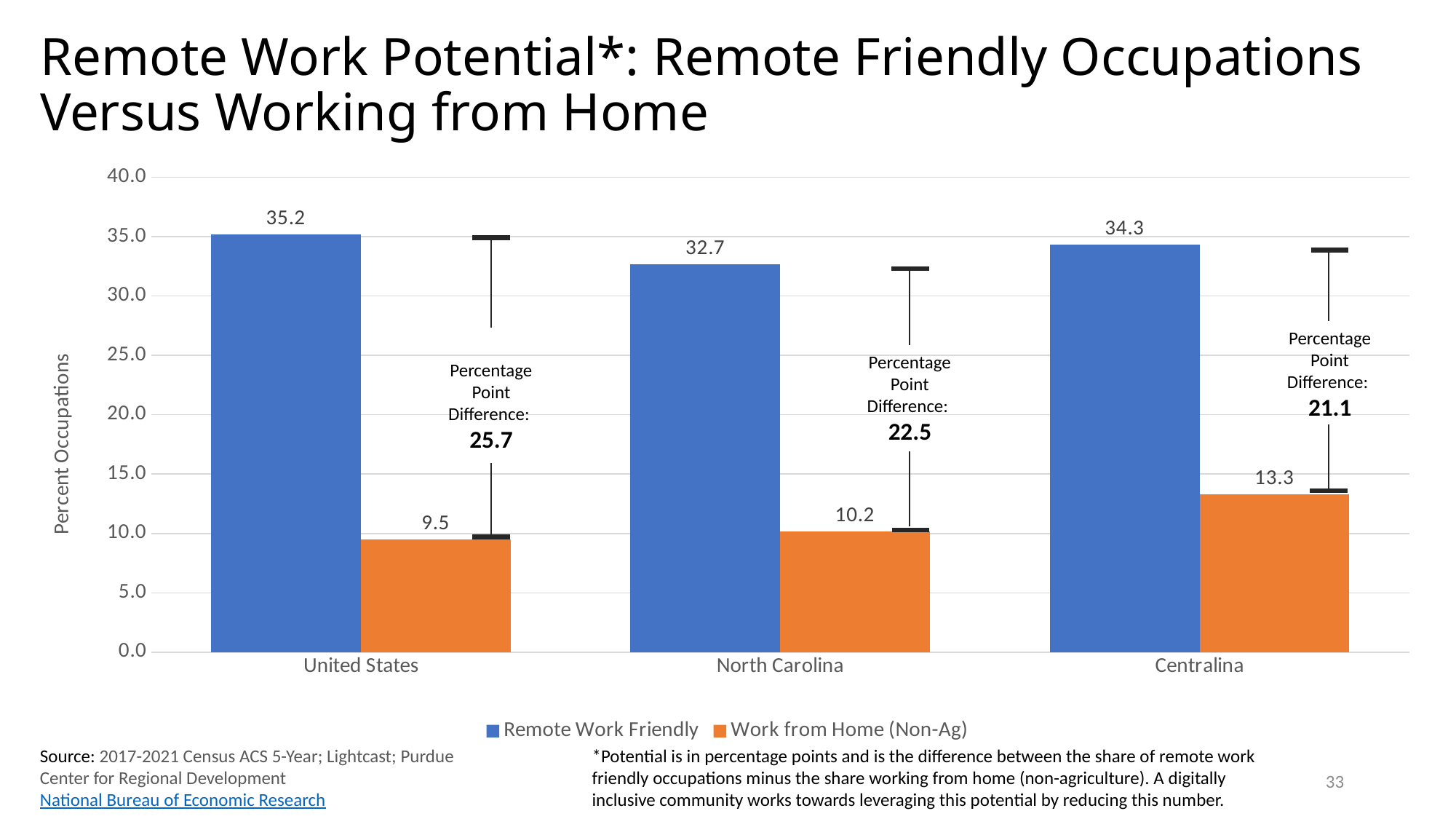
What is the Work from Home (Non-Ag) value for Centralina? 13.3 What is the label of the y axis? Percent Occupations How many series does the legend list? 2 Is the Work from Home (Non-Ag) value for Centralina greater or less than 10.0? greater Which category has the lowest Work from Home (Non-Ag) value? United States Which category has the highest Remote Work Friendly value? United States What is the Remote Work Friendly value for the United States? 35.2 What is the Work from Home (Non-Ag) value for North Carolina? 10.2 How many categories are shown on the x axis? 3 What kind of chart is shown on the slide? bar chart Which is larger: the Remote Work Friendly value for Centralina or for North Carolina? Centralina What is the difference between the Remote Work Friendly and Work from Home (Non-Ag) values for North Carolina? 22.5